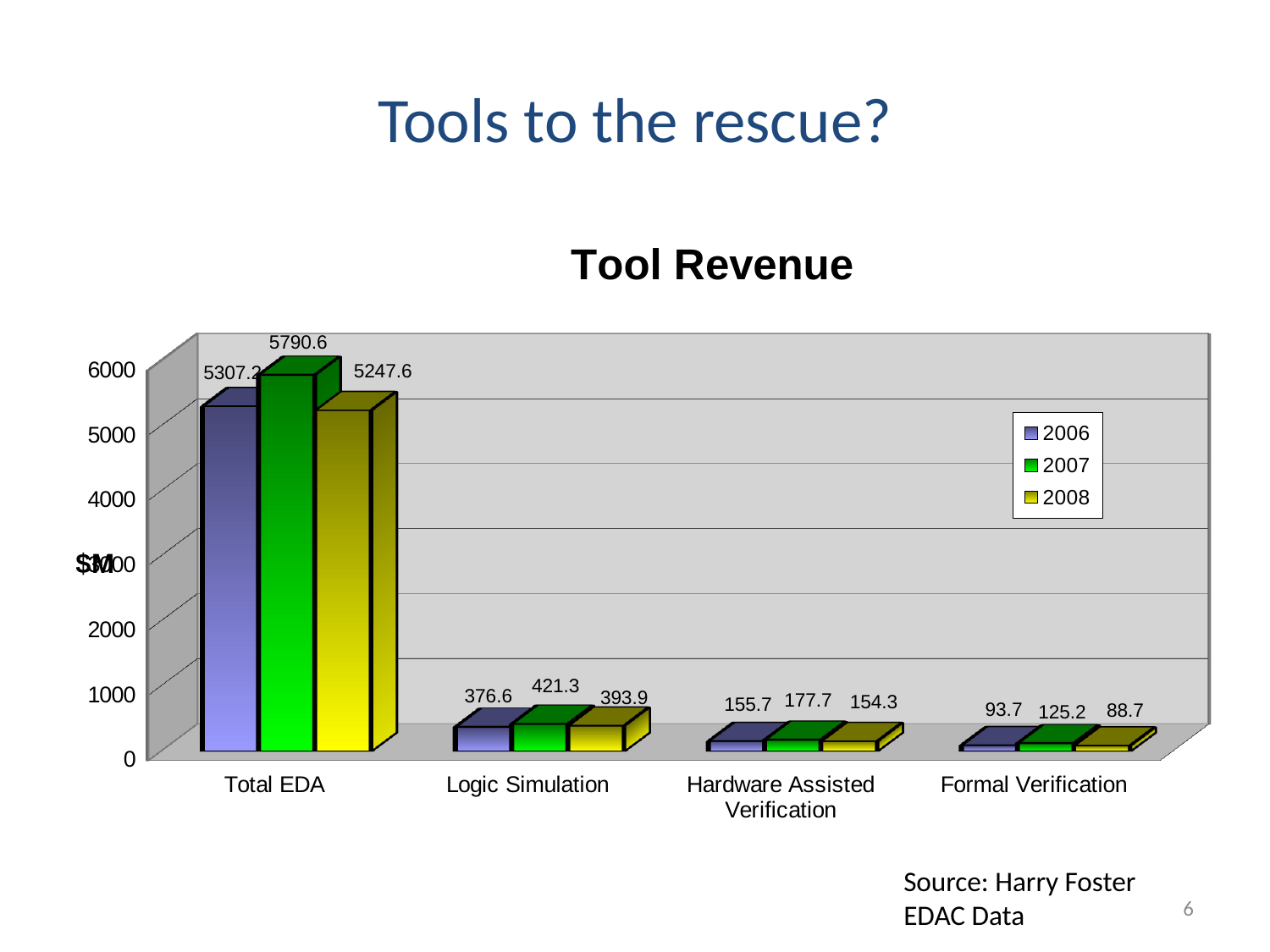
What kind of chart is shown? bar chart Is the 2008 value for Total EDA greater or less than 5000? greater Which year has the lowest value for Formal Verification? 2008 Which is larger, the 2006 value for Logic Simulation or the 2008 value for Logic Simulation? 2008 What is the 2007 value for Formal Verification? 125.2 What is the 2008 value for Logic Simulation? 393.9 What is the 2007 value for Total EDA? 5790.6 How many categories are shown on the x axis? 4 Which year has the highest value for Logic Simulation? 2007 What is the 2006 value for Hardware Assisted Verification? 155.7 How many series does the legend list? 3 What is the difference between the 2007 and 2008 values for Hardware Assisted Verification? 23.4